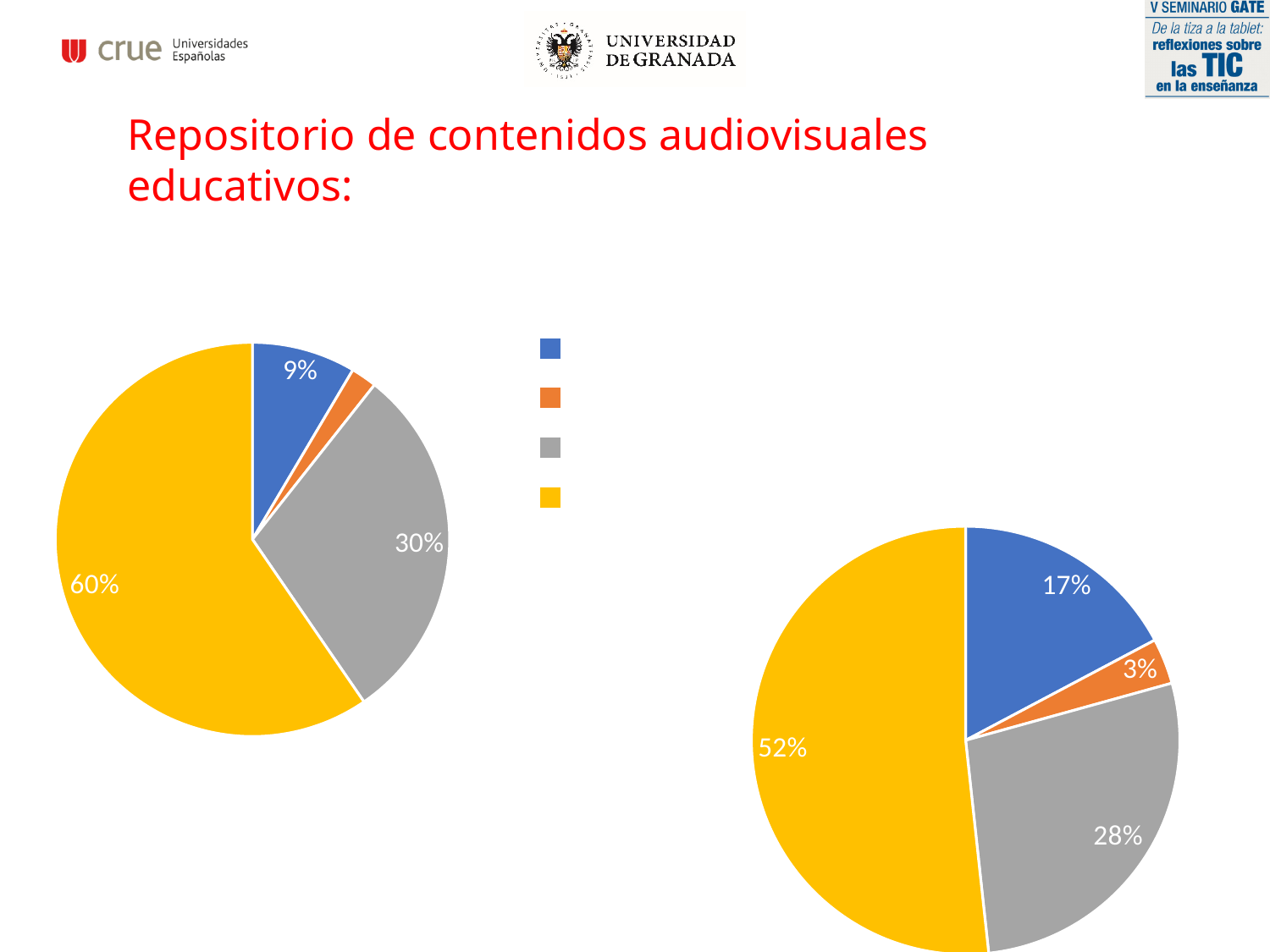
In the pie chart on the right, what percentage does the blue slice represent? 17% What type of chart is shown on the left of the slide? pie chart In the pie chart on the right, which is larger, the grey slice or the blue slice? grey In the pie chart on the left, which colour slice is the largest? yellow In the pie chart on the left, what percentage does the blue slice represent? 9% In the pie chart on the right, what percentage does the orange slice represent? 3% In the pie chart on the right, what percentage does the yellow slice represent? 52% In the pie chart on the left, what percentage does the yellow slice represent? 60% In the pie chart on the left, which colour slice is the smallest? orange How many entries does the legend between the two pie charts list? 4 In the pie chart on the left, what percentage does the grey slice represent? 30% In the pie chart on the right, what is the difference between the grey slice and the blue slice? 11%